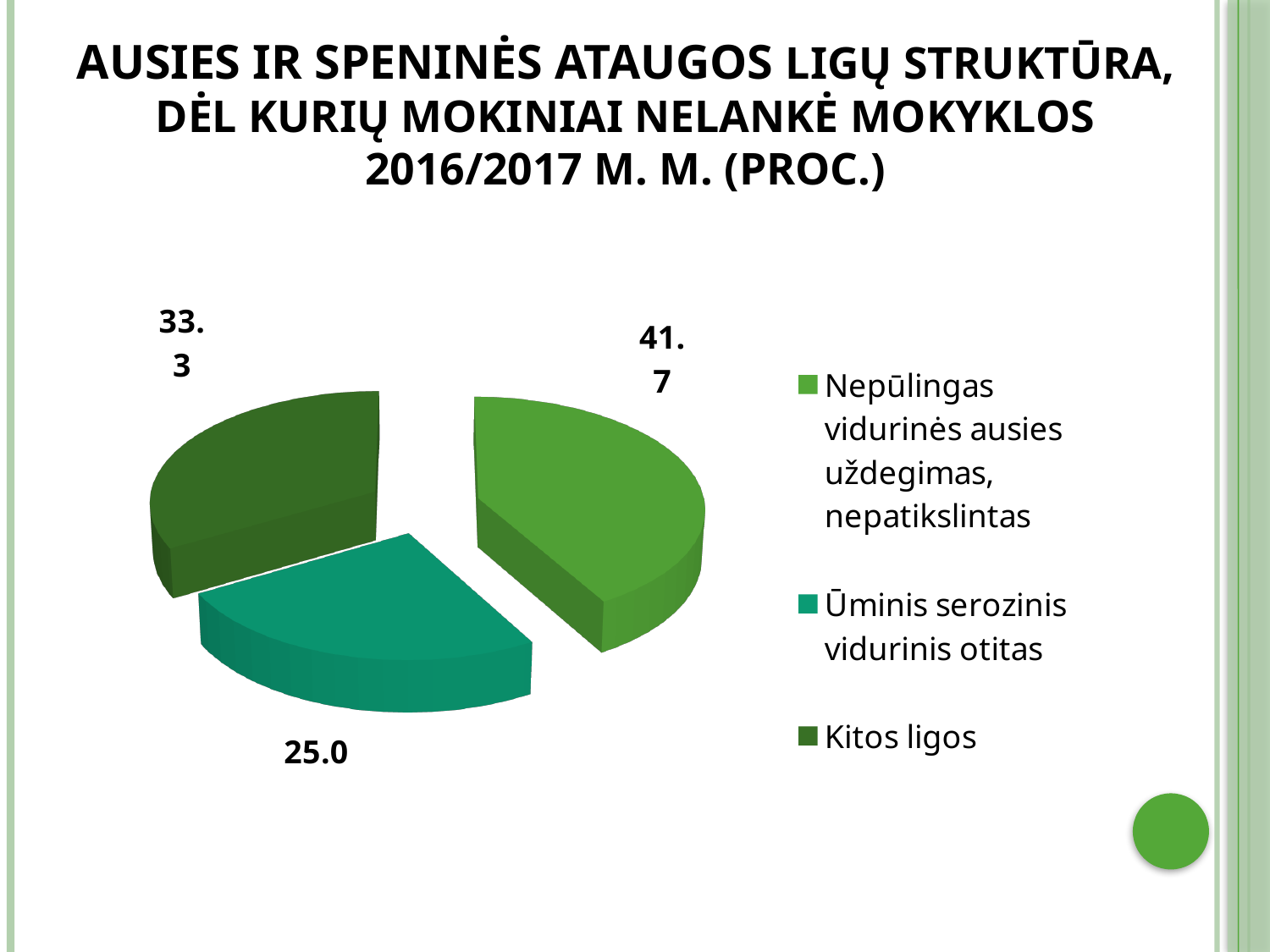
What is the difference between the values for Nepūlingas vidurinės ausies uždegimas, nepatikslintas and Kitos ligos? 8.4 What kind of chart is shown on the slide? pie chart What is the value for Ūminis serozinis vidurinis otitas? 25.0 What is the value for Nepūlingas vidurinės ausies uždegimas, nepatikslintas? 41.7 Which category has the smallest slice of the pie? Ūminis serozinis vidurinis otitas What is the difference between the values for Kitos ligos and Ūminis serozinis vidurinis otitas? 8.3 Which category has the largest slice of the pie? Nepūlingas vidurinės ausies uždegimas, nepatikslintas Which is larger: the value for Kitos ligos or the value for Ūminis serozinis vidurinis otitas? Kitos ligos What school year does the chart title refer to? 2016/2017 m. m. How many entries does the legend list? 3 What is the value for Kitos ligos? 33.3 How many slices does the pie chart have? 3